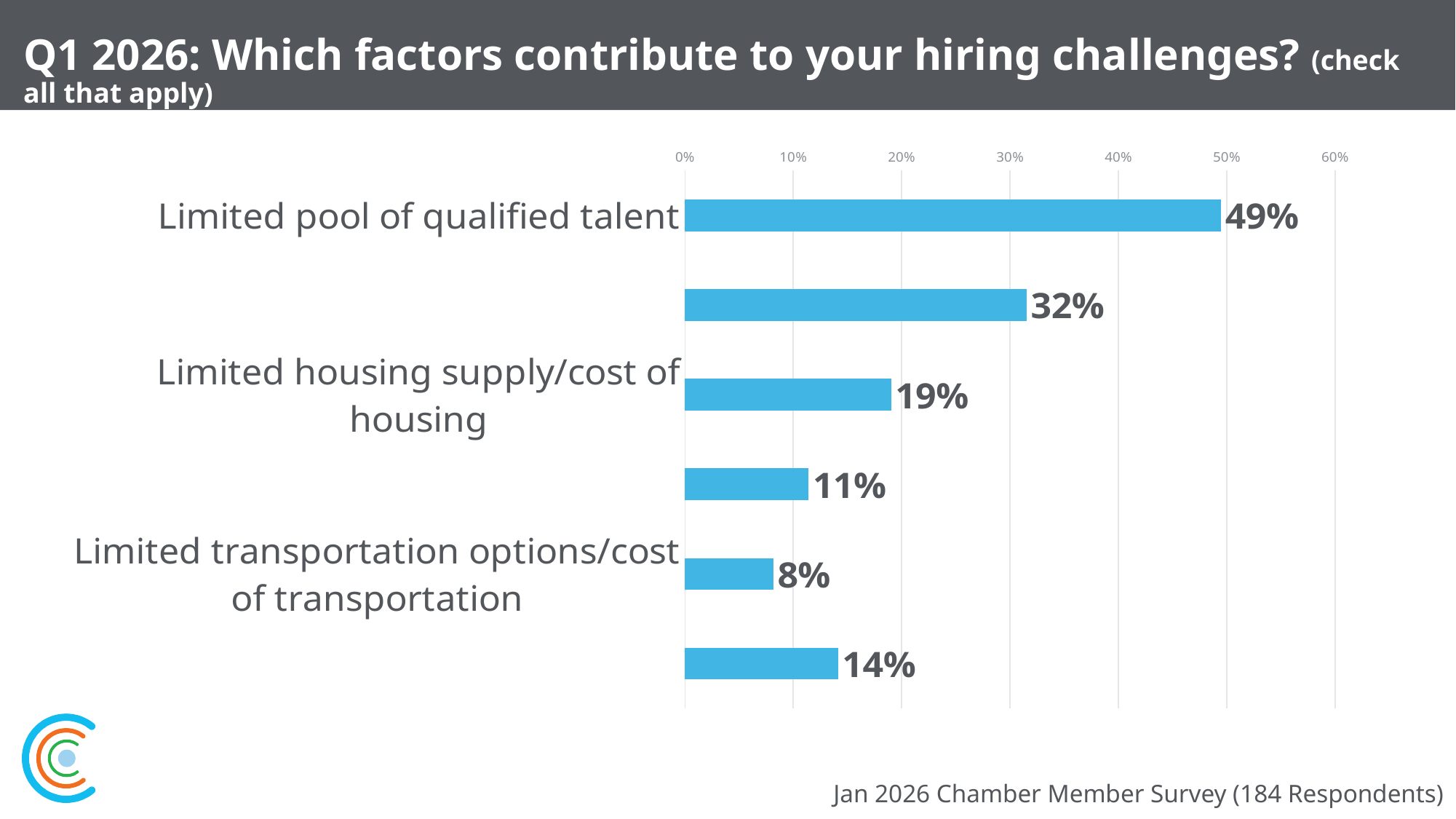
According to the source note, how many respondents took part in the survey? 184 Which factor has the highest percentage in the chart? Limited pool of qualified talent What is the difference in percentage points between "Limited housing supply/cost of housing" and "Limited transportation options/cost of transportation"? 11 percentage points What is the difference in percentage points between "Limited pool of qualified talent" and "Limited housing supply/cost of housing"? 30 percentage points Which is larger: the value for "Limited housing supply/cost of housing" or the value for "Limited transportation options/cost of transportation"? Limited housing supply/cost of housing What percentage of respondents selected "Limited pool of qualified talent"? 49% What percentage of respondents selected "Limited housing supply/cost of housing"? 19% How many bars are plotted in the chart? 6 Is the value for "Limited pool of qualified talent" greater or less than 40%? greater Which factor has the lowest percentage in the chart? Limited transportation options/cost of transportation What kind of chart is shown on the slide? Bar chart What percentage of respondents selected "Limited transportation options/cost of transportation"? 8%